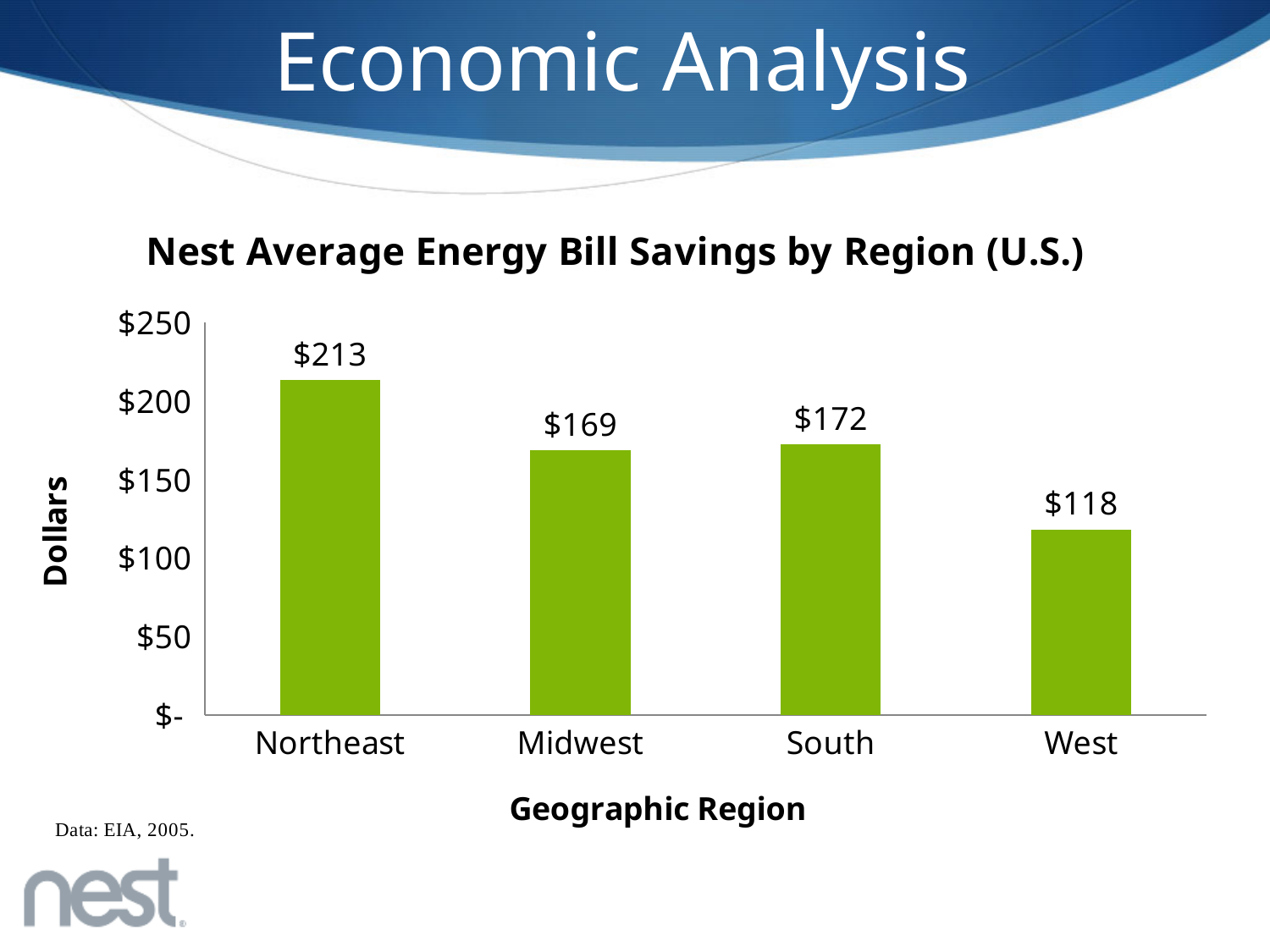
What kind of chart is shown on the slide? Bar chart What is the average energy bill savings for the Northeast region? $213 How many regions are shown in the chart? 4 Is the value for the West greater or less than $150? less What is the average energy bill savings for the West region? $118 What is the average energy bill savings for the Midwest region? $169 Which region has the highest average energy bill savings? Northeast Which region has larger savings, the Northeast or the South? Northeast What is the difference in savings between the Northeast and the West? $95 What is the difference in savings between the South and the Midwest? $3 What is the title of the chart? Nest Average Energy Bill Savings by Region (U.S.) Which region has the lowest average energy bill savings? West